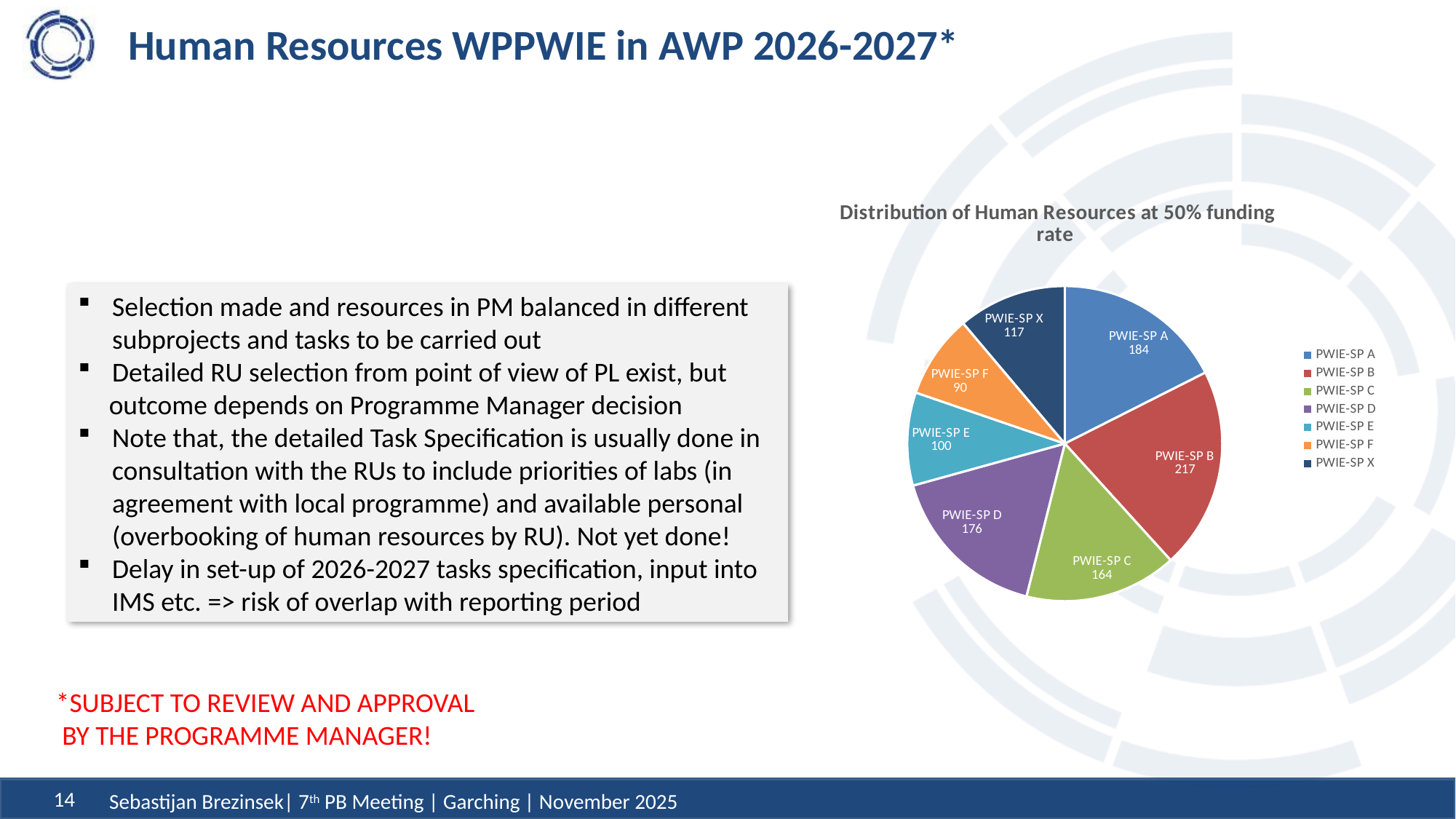
How many slices does the pie chart have? 7 What is the difference between the values for PWIE-SP A and PWIE-SP C? 20 What is the value for PWIE-SP E? 100 Which subproject has the smallest slice? PWIE-SP F What is the value for PWIE-SP X? 117 Which subproject has the largest slice? PWIE-SP B What type of chart is shown on the slide? pie chart What is the chart's title? Distribution of Human Resources at 50% funding rate Which is larger, the value for PWIE-SP D or PWIE-SP A? PWIE-SP A What is the value for PWIE-SP B? 217 How many entries does the legend list? 7 What is the total of all slices in the pie chart? 1048